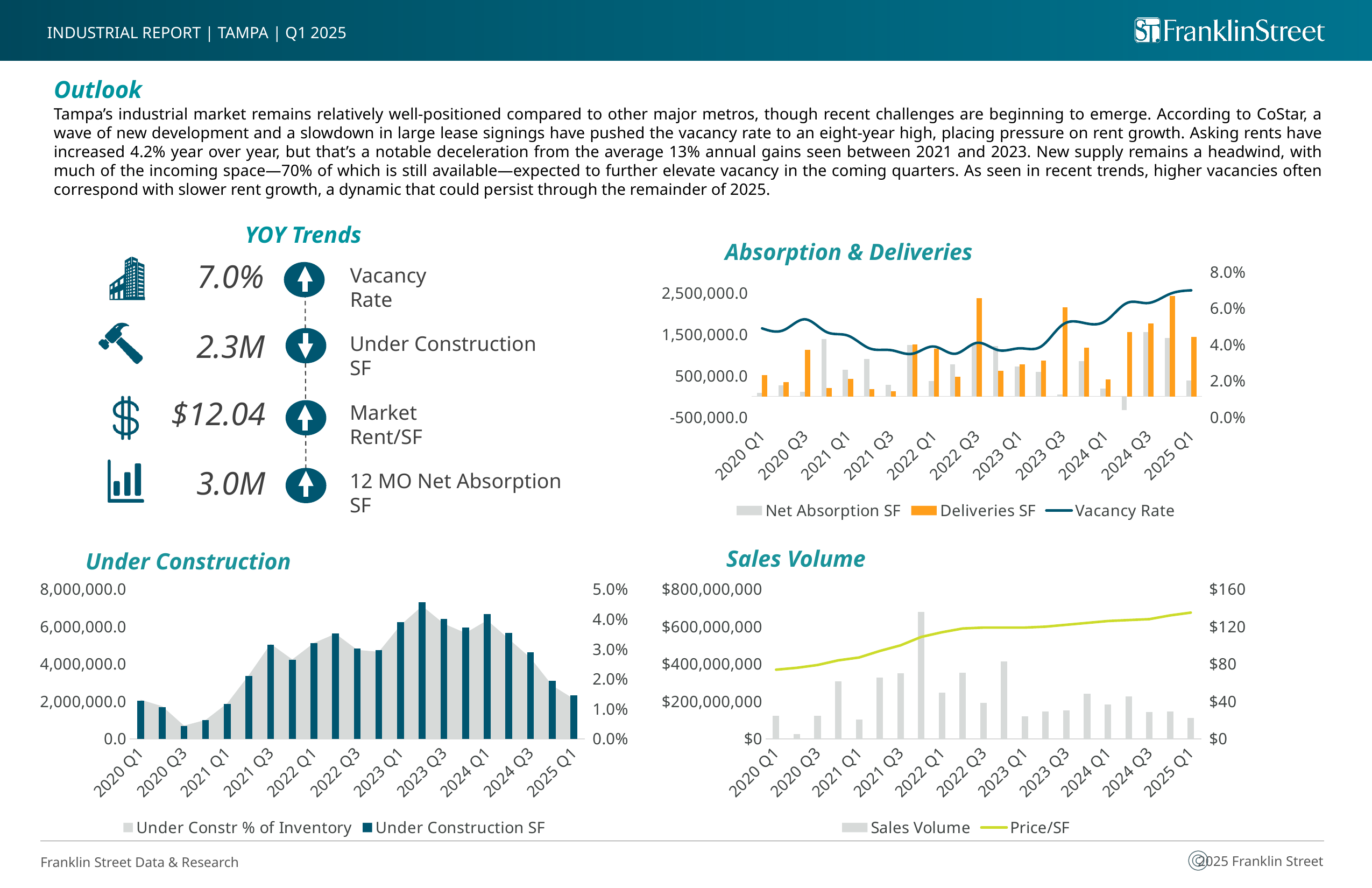
In the Absorption & Deliveries chart, which is larger: Deliveries SF in 2022 Q3 or in 2020 Q1? 2022 Q3 In the Absorption & Deliveries chart, is the Vacancy Rate for 2025 Q1 greater or less than 6.0%? greater In the Absorption & Deliveries chart, does the Vacancy Rate line generally rise or fall from 2020 Q1 to 2025 Q1? rise In the Under Construction chart, how many series does the legend list? 2 In the Absorption & Deliveries chart, which quarter has the highest Deliveries SF bar? 2024 Q4 What colour are the Deliveries SF bars in the Absorption & Deliveries chart? Orange In the Absorption & Deliveries chart, how many series does the legend list? 3 In the Sales Volume chart, is the Price/SF for 2025 Q1 greater or less than $120? greater In the Under Construction chart, is the Under Construction SF for 2025 Q1 greater or less than 4,000,000.0? less In the Sales Volume chart, which quarter has the highest Sales Volume bar? 2021 Q4 In the Under Construction chart, which quarter has the lowest Under Construction SF bar? 2020 Q3 In the Sales Volume chart, does the Price/SF line rise or fall from 2020 Q1 to 2025 Q1? rise